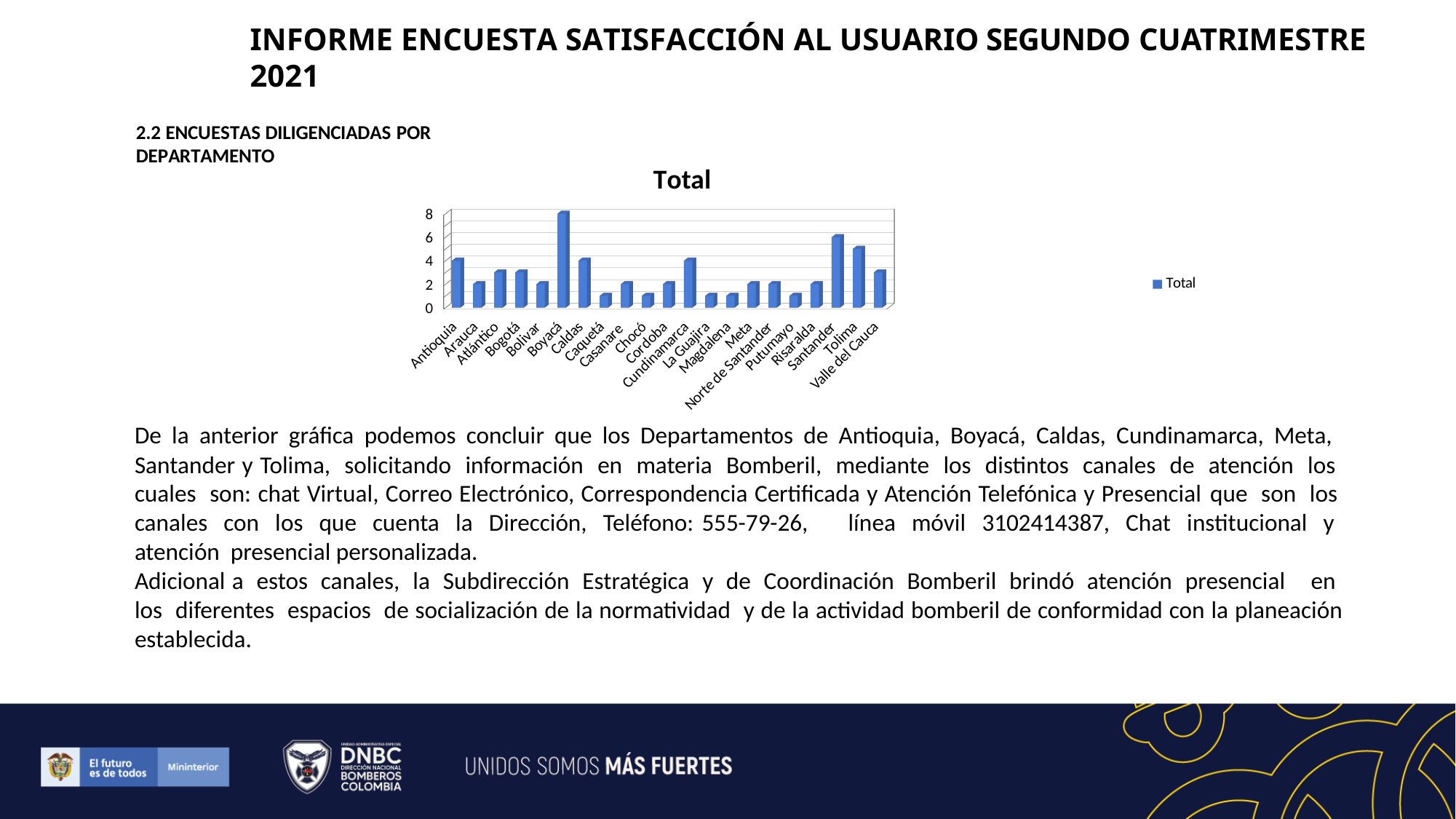
What is the value for Santander? 6 Is the value for Tolima greater or less than 4? greater What is the difference between the values for Boyacá and Santander? 2 What is the title of the chart? Total What is the value for Antioquia? 4 How many departments (categories) are shown on the x axis of the chart? 21 Which is larger, the value for Santander or the value for Antioquia? Santander What type of chart is shown on the slide? Bar chart Is the value for Caquetá greater or less than 2? less Which department has the highest value in the chart? Boyacá What is the value for Boyacá? 8 How many series does the legend list? 1